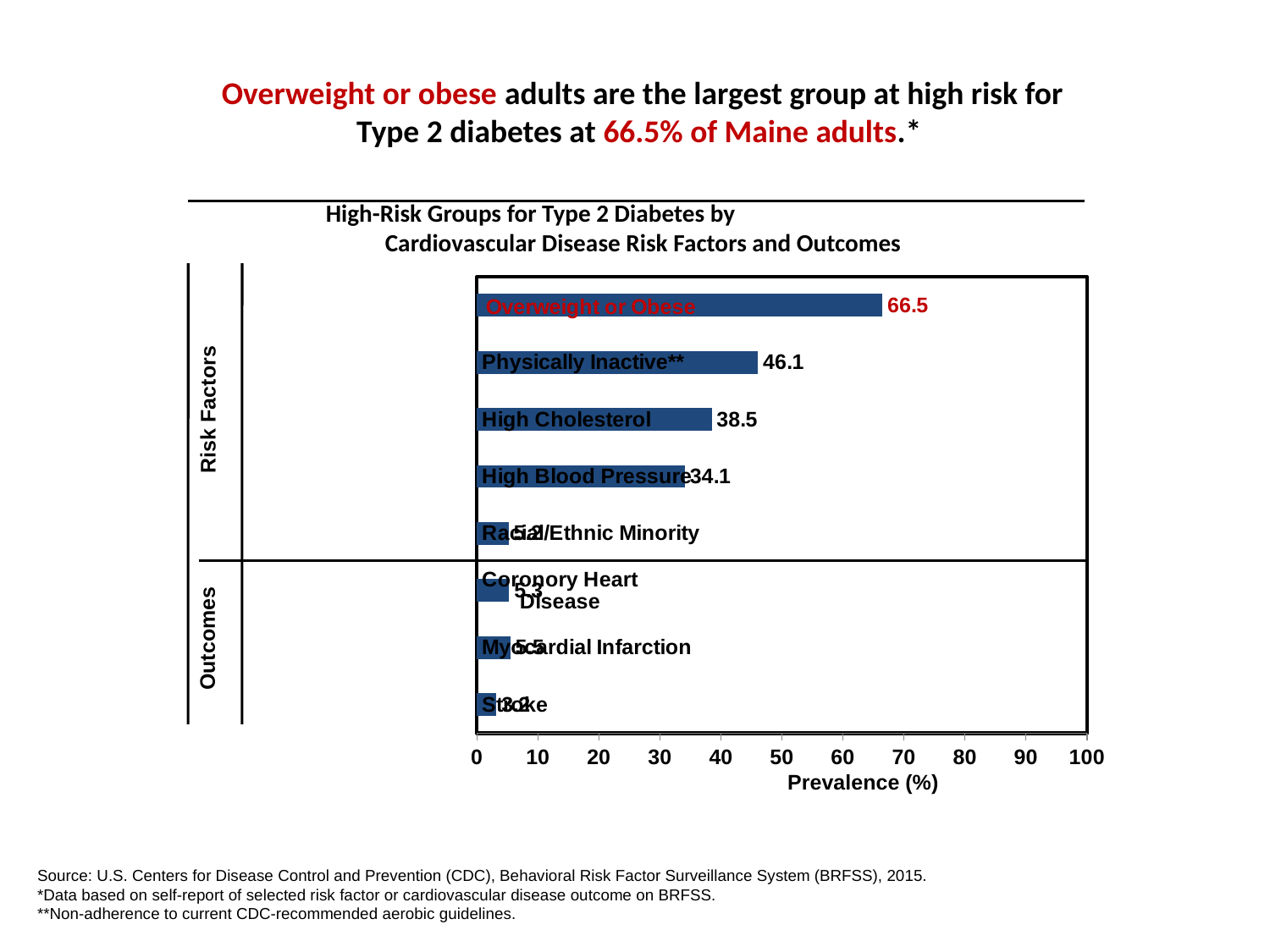
What is the difference in prevalence between Overweight or Obese and Physically Inactive**? 20.4 How many categories are plotted in the chart? 8 What is the prevalence (%) for Overweight or Obese? 66.5 What type of chart is shown on the slide? bar chart What is the label of the horizontal axis? Prevalence (%) What is the prevalence (%) for High Cholesterol? 38.5 What is the difference in prevalence between High Cholesterol and High Blood Pressure? 4.4 Which category has the highest prevalence? Overweight or Obese Which has a higher prevalence, High Cholesterol or High Blood Pressure? High Cholesterol Is the value for Stroke greater or less than 10? less What is the prevalence (%) for High Blood Pressure? 34.1 What is the prevalence (%) for Physically Inactive**? 46.1